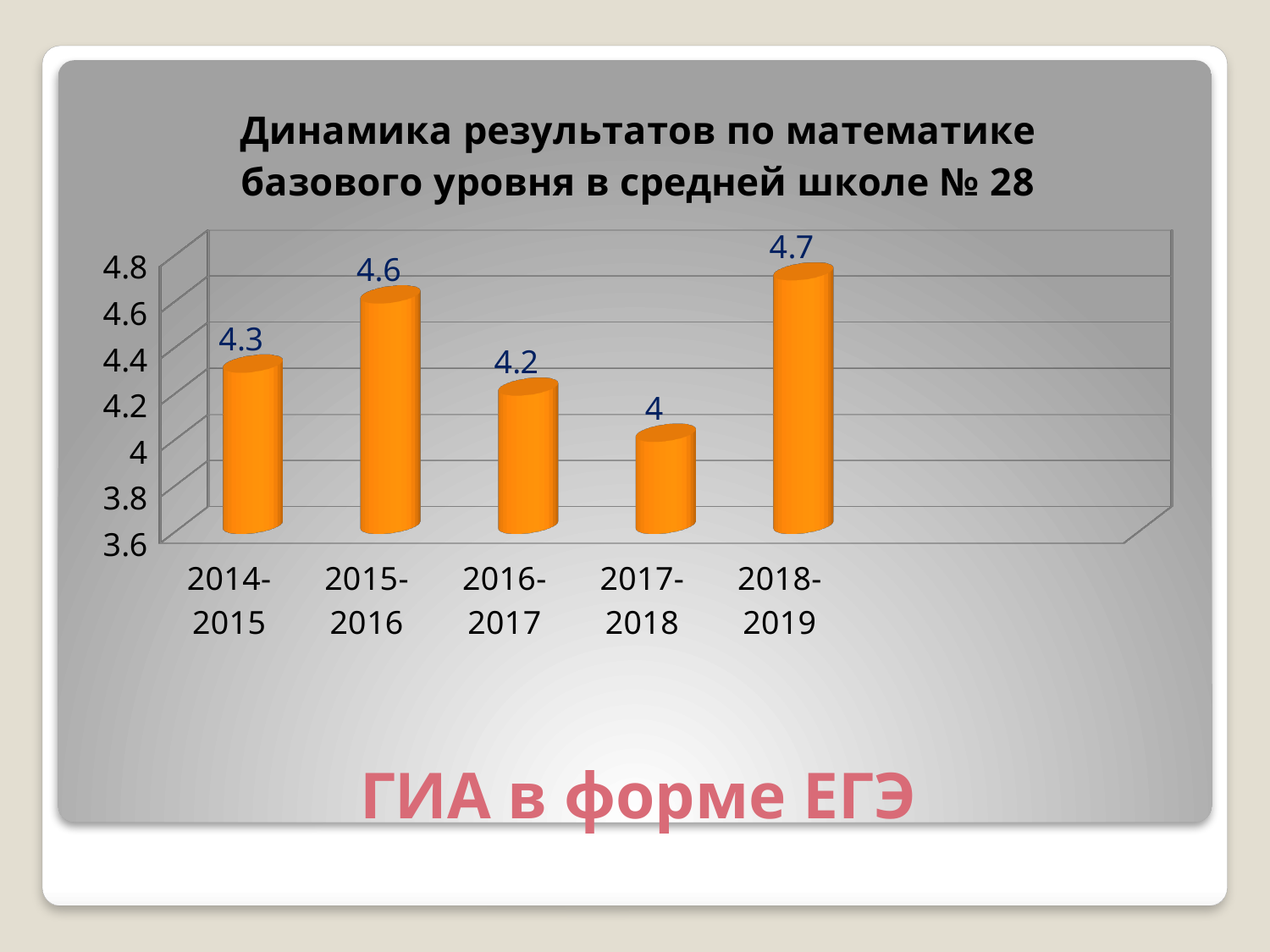
What is the value for 2014-2015? 4.3 Which school year has the highest value? 2018-2019 How many school years are shown on the chart? 5 What is the title of the chart? Динамика результатов по математике базового уровня в средней школе № 28 Which school year has the lowest value? 2017-2018 What is the difference between the values for 2018-2019 and 2017-2018? 0.7 Is the value for 2015-2016 greater or less than 4.4? greater Which is larger, the value for 2014-2015 or the value for 2016-2017? 2014-2015 What kind of chart is shown on the slide? bar chart What is the value for 2017-2018? 4 What is the difference between the values for 2015-2016 and 2016-2017? 0.4 What is the value for 2018-2019? 4.7